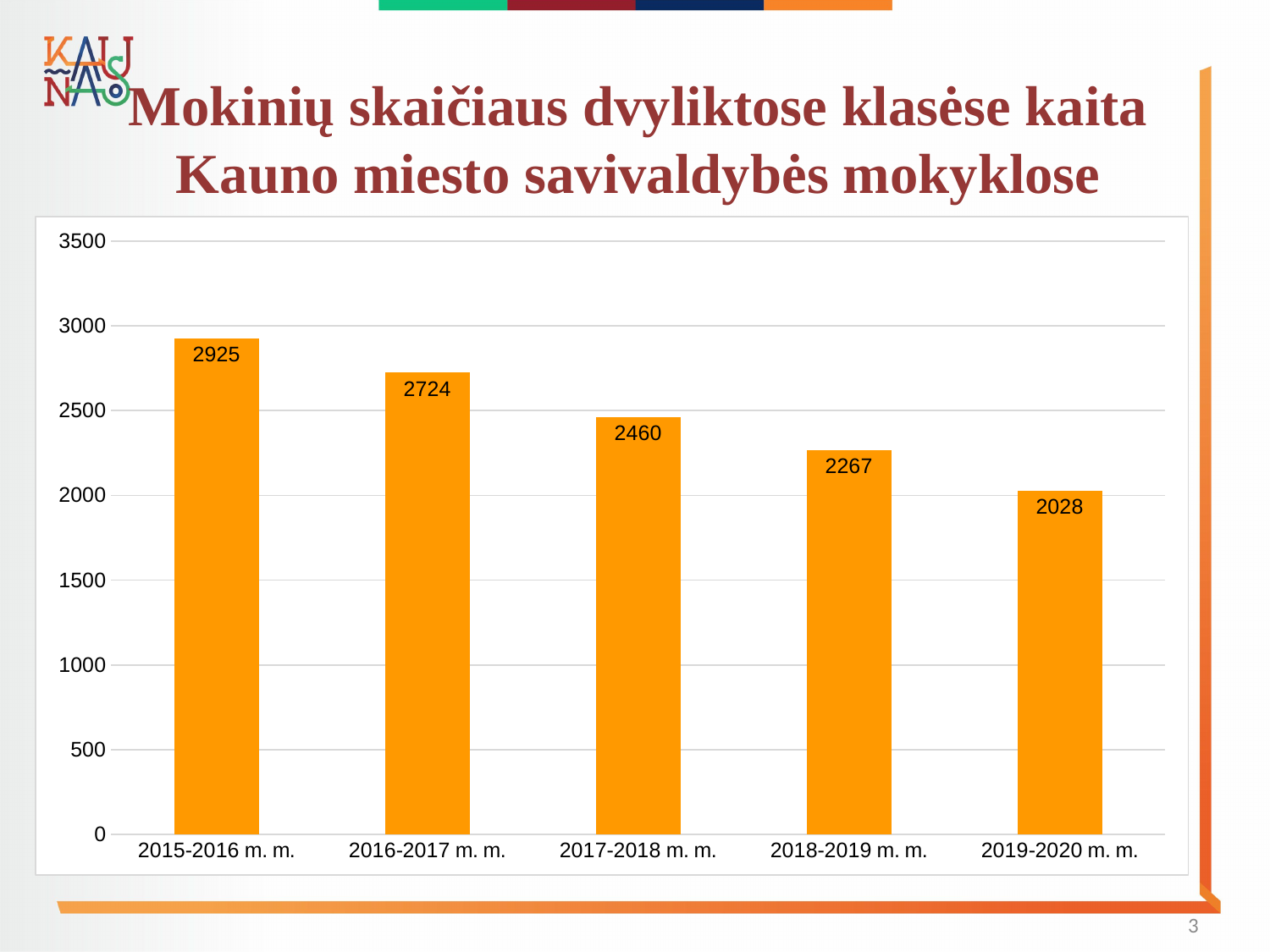
What kind of chart is shown on the slide? bar chart Which school year has the lowest value? 2019-2020 m. m. What is the difference between the values for 2016-2017 m. m. and 2017-2018 m. m.? 264 Is the value for 2018-2019 m. m. greater or less than 2500? less Which school year has the highest value? 2015-2016 m. m. Which is larger, the value for 2016-2017 m. m. or the value for 2018-2019 m. m.? 2016-2017 m. m. What is the value for 2017-2018 m. m.? 2460 What is the value for 2015-2016 m. m.? 2925 What is the difference between the values for 2015-2016 m. m. and 2019-2020 m. m.? 897 Do the values rise or fall from 2015-2016 m. m. to 2019-2020 m. m.? fall What is the value for 2019-2020 m. m.? 2028 How many school years are shown on the chart? 5